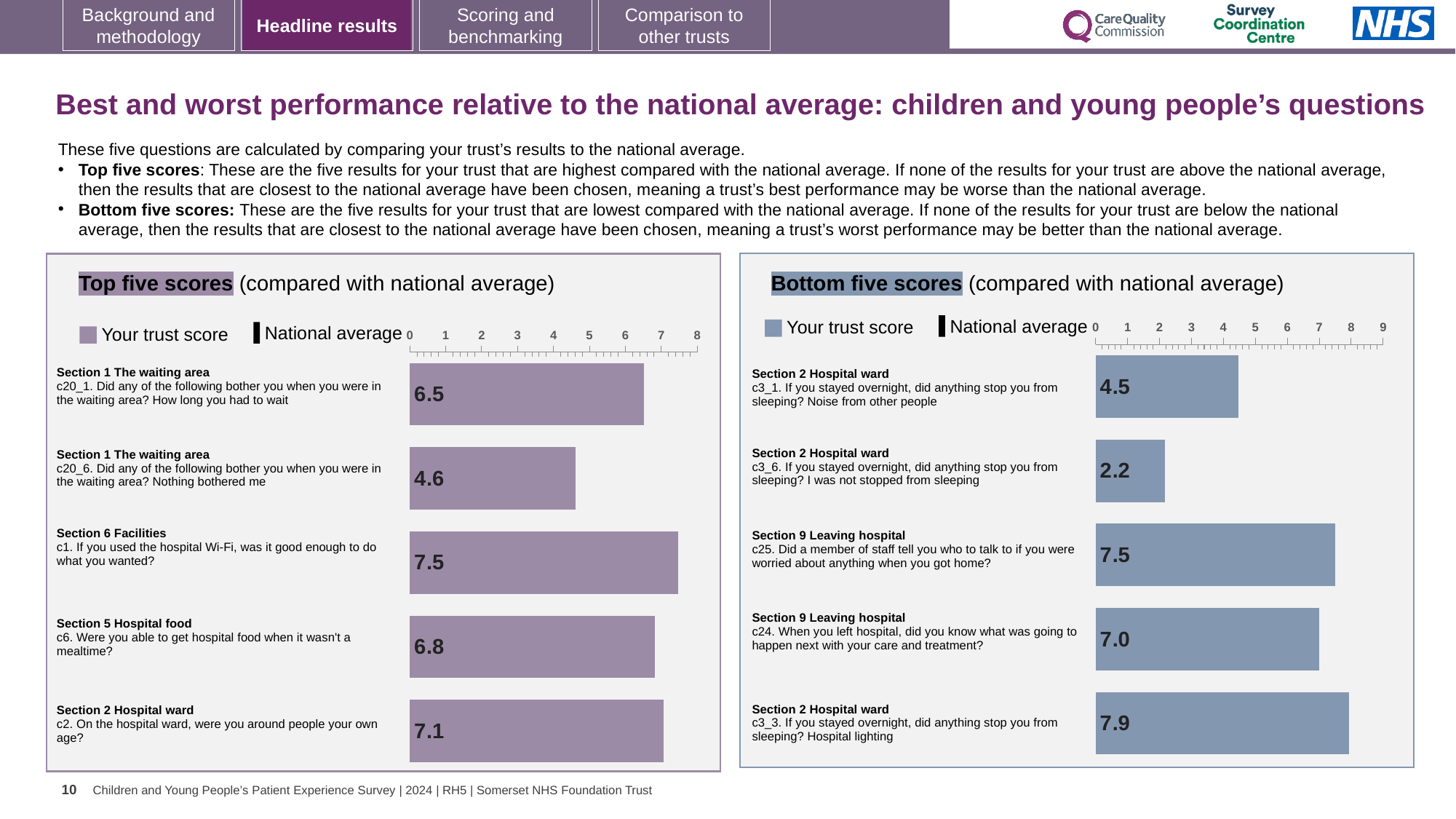
In the Bottom five scores chart, what is the difference between the trust score for c24 and c3_1? 2.5 What type of chart is the Top five scores chart? Bar chart In the Top five scores chart, which question has the highest trust score? c1. If you used the hospital Wi-Fi, was it good enough to do what you wanted? (7.5) In the Bottom five scores chart, what is the trust score for c25 'Did a member of staff tell you who to talk to if you were worried about anything when you got home?' 7.5 In the Top five scores chart, what is the trust score for c20_1 about how long you had to wait in the waiting area? 6.5 In the Top five scores chart, which question has the lowest trust score? c20_6. Nothing bothered me (4.6) How many bars are plotted in the Bottom five scores chart? 5 In the Top five scores chart, what is the trust score for c6 'Were you able to get hospital food when it wasn't a mealtime?' 6.8 In the Top five scores chart, what is the difference between the trust score for c2 (around people your own age) and c20_1 (how long you had to wait)? 0.6 In the Bottom five scores chart, which question has the lowest trust score? c3_6. I was not stopped from sleeping (2.2) In the Bottom five scores chart, which question has the highest trust score? c3_3. Hospital lighting (7.9) In the Top five scores chart, which has the larger trust score: c20_1 (how long you had to wait) or c6 (hospital food when it wasn't a mealtime)? c6 (6.8)